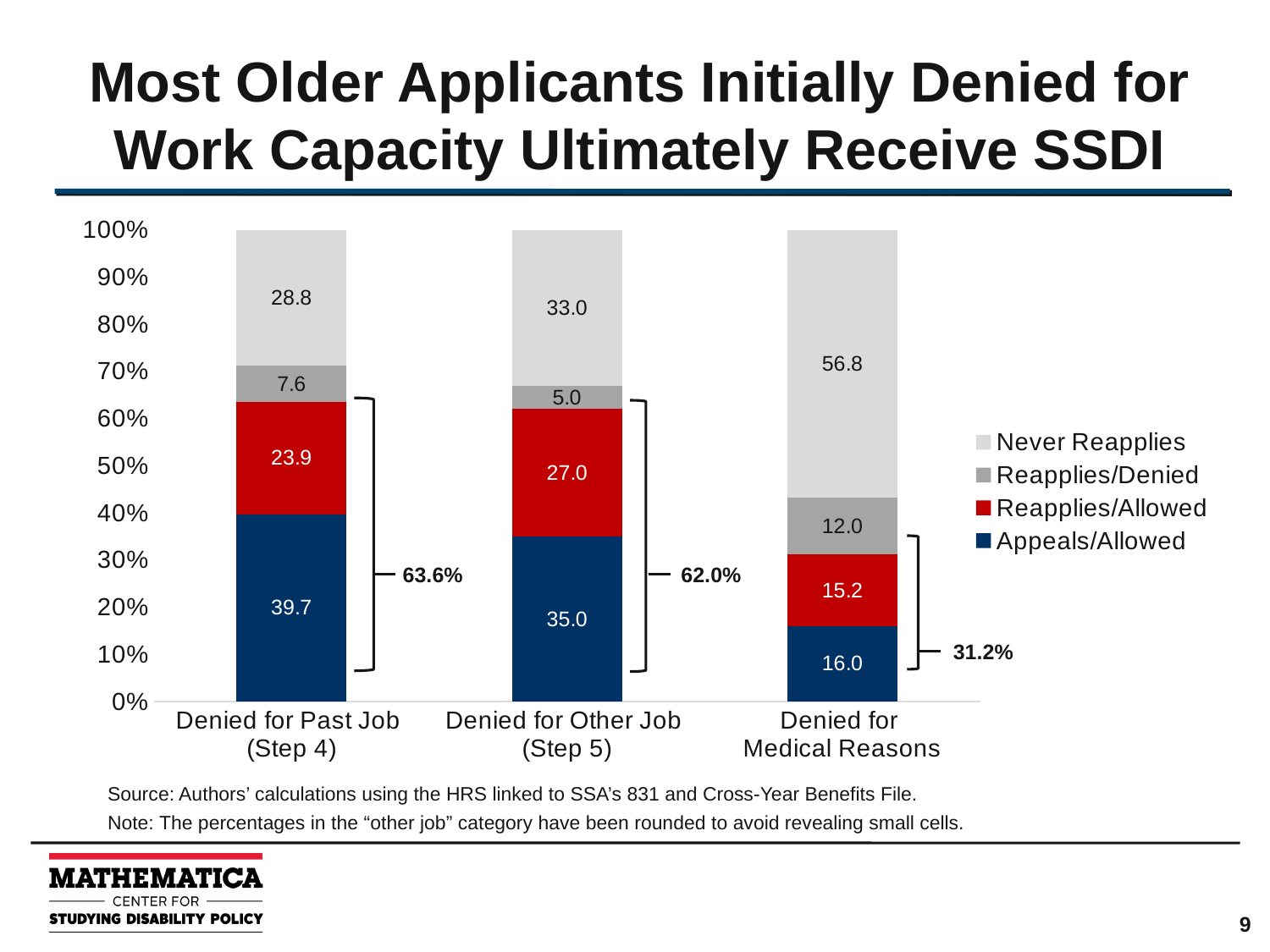
Which category has the highest Never Reapplies value? Denied for Medical Reasons What is the Appeals/Allowed value for Denied for Past Job (Step 4)? 39.7 What is the Never Reapplies value for Denied for Medical Reasons? 56.8 Which legend entry is shown in red? Reapplies/Allowed Which category has the lowest Appeals/Allowed value? Denied for Medical Reasons How many categories are shown on the x axis? 3 What is the Reapplies/Denied value for Denied for Other Job (Step 5)? 5.0 What kind of chart is shown on the slide? Stacked bar chart What is the difference between the Reapplies/Allowed values for Denied for Other Job (Step 5) and Denied for Past Job (Step 4)? 3.1 Which is larger: the Reapplies/Denied value for Denied for Medical Reasons or for Denied for Past Job (Step 4)? Denied for Medical Reasons What combined percentage is shown by the bracket for Appeals/Allowed and Reapplies/Allowed in the Denied for Medical Reasons bar? 31.2% How many series does the legend list? 4